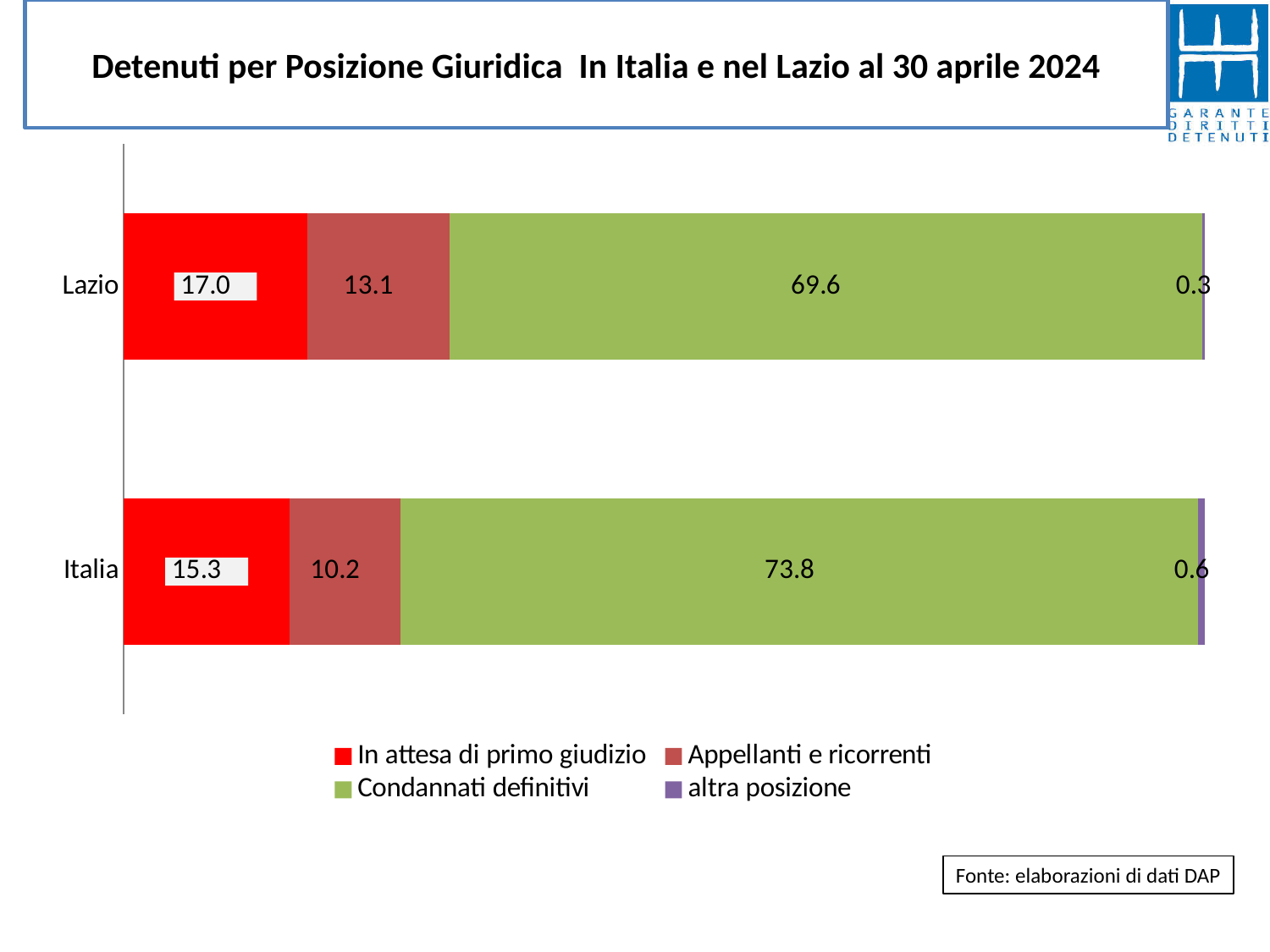
How many categories are shown on the chart? 2 Which category has the higher value for "Condannati definitivi", Lazio or Italia? Italia What is the difference between the "In attesa di primo giudizio" values for Lazio and Italia? 1.7 What is the value for "Condannati definitivi" for Italia? 73.8 What kind of chart is shown on the slide? Stacked bar chart What is the difference between the "Condannati definitivi" values for Italia and Lazio? 4.2 How many series does the legend list? 4 What is the total of the stacked bar for Lazio? 100.0 What is the value for "Appellanti e ricorrenti" for Lazio? 13.1 What is the value for "In attesa di primo giudizio" for Lazio? 17.0 What is the value for "altra posizione" for Italia? 0.6 Which category has the higher value for "Appellanti e ricorrenti", Lazio or Italia? Lazio